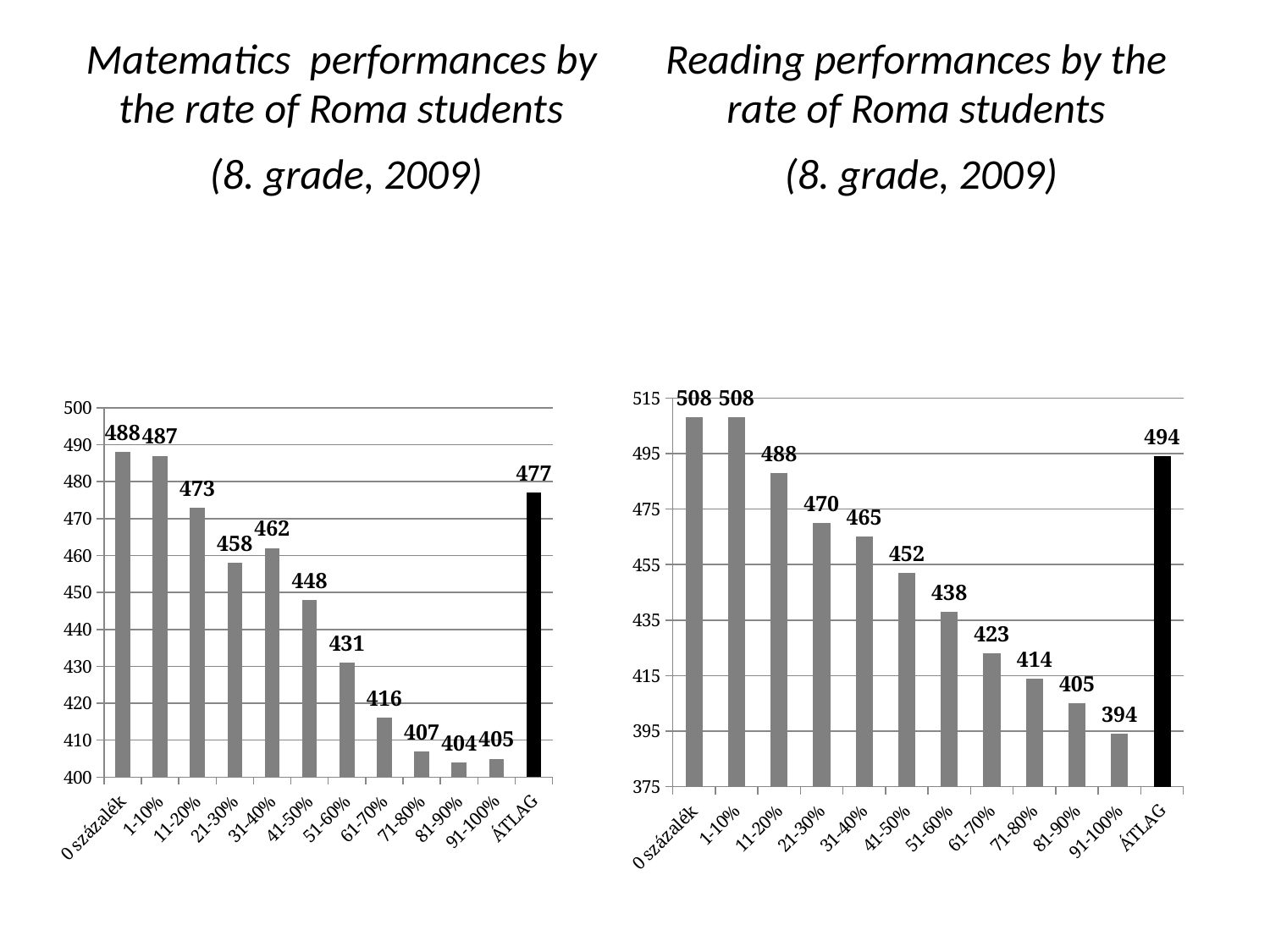
What kind of chart is the Reading performances chart? Bar chart In the Mathematics performances chart, what is the value of the ÁTLAG bar? 477 In the Reading performances chart, which is larger: the value for 31-40% or the value for 51-60%? 31-40% In the Reading performances chart, what is the value for the 61-70% category? 423 In the Mathematics performances chart, which category has the lowest value? 81-90% In the Mathematics performances chart, what colour is the ÁTLAG bar? Black In the Mathematics performances chart, what is the value for the 41-50% category? 448 In the Reading performances chart, what is the difference between the 0 százalék value and the 91-100% value? 114 In the Mathematics performances chart, what is the difference between the 11-20% value and the 21-30% value? 15 In the Mathematics performances chart, how many bars are plotted? 12 In the Reading performances chart, do the values rise or fall from 0 százalék to 91-100%? Fall In the Reading performances chart, which category has the lowest value? 91-100%